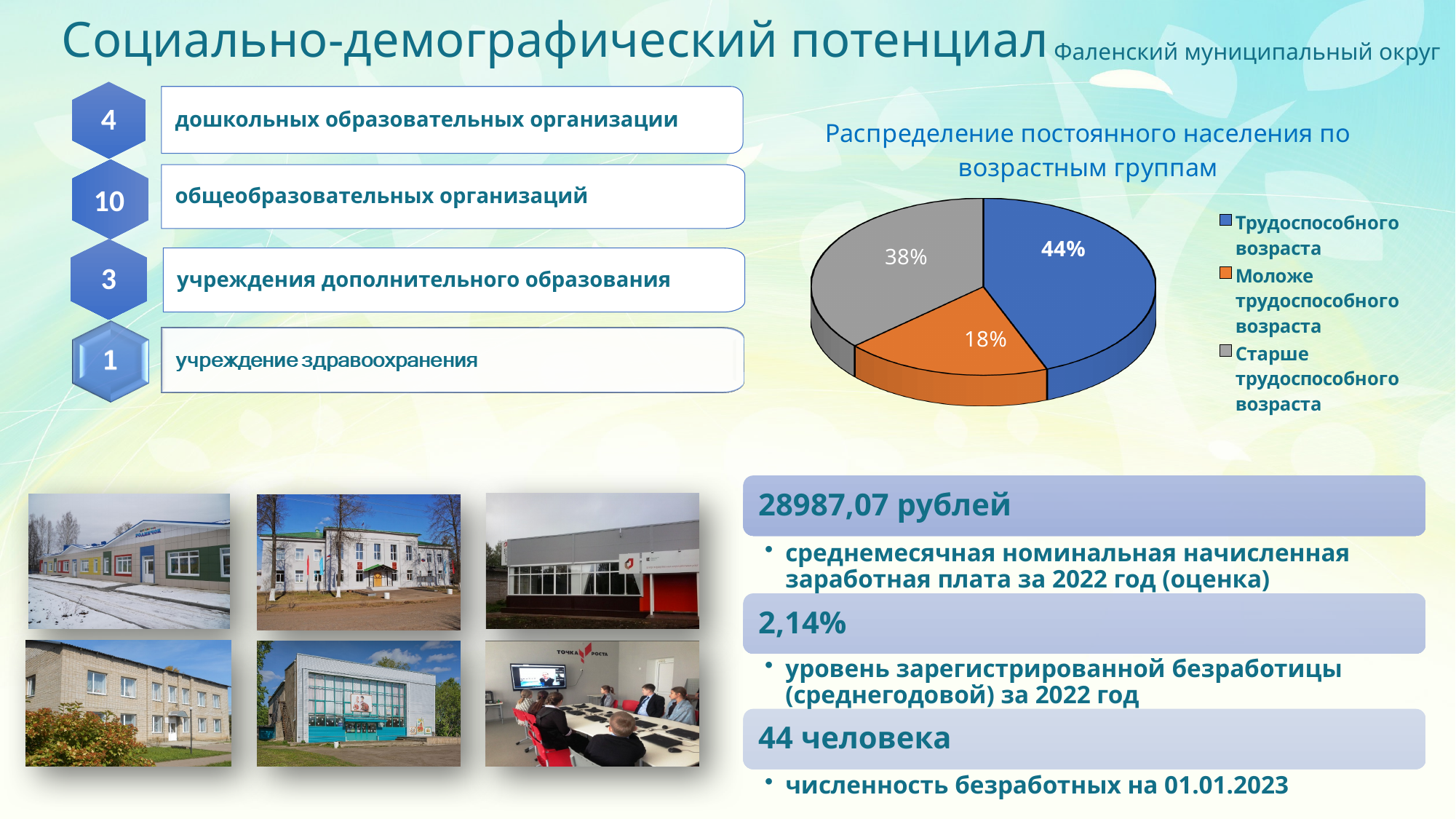
Which is larger: the share younger than working age or the share older than working age? Старше трудоспособного возраста Which age group has the largest share of the permanent population? Трудоспособного возраста What share of the permanent population is younger than working age (Моложе трудоспособного возраста)? 18% What type of chart is used to show the distribution of the permanent population by age group? Pie chart What share of the permanent population is of working age (Трудоспособного возраста)? 44% By how many percentage points does the share older than working age exceed the share younger than working age? 20% What is the title of the chart on the slide? Распределение постоянного населения по возрастным группам What colour is the slice for the working-age group (Трудоспособного возраста)? Blue Which age group has the smallest share of the permanent population? Моложе трудоспособного возраста How many age groups are shown in the pie chart? 3 By how many percentage points does the working-age share exceed the share older than working age? 6% What share of the permanent population is older than working age (Старше трудоспособного возраста)? 38%